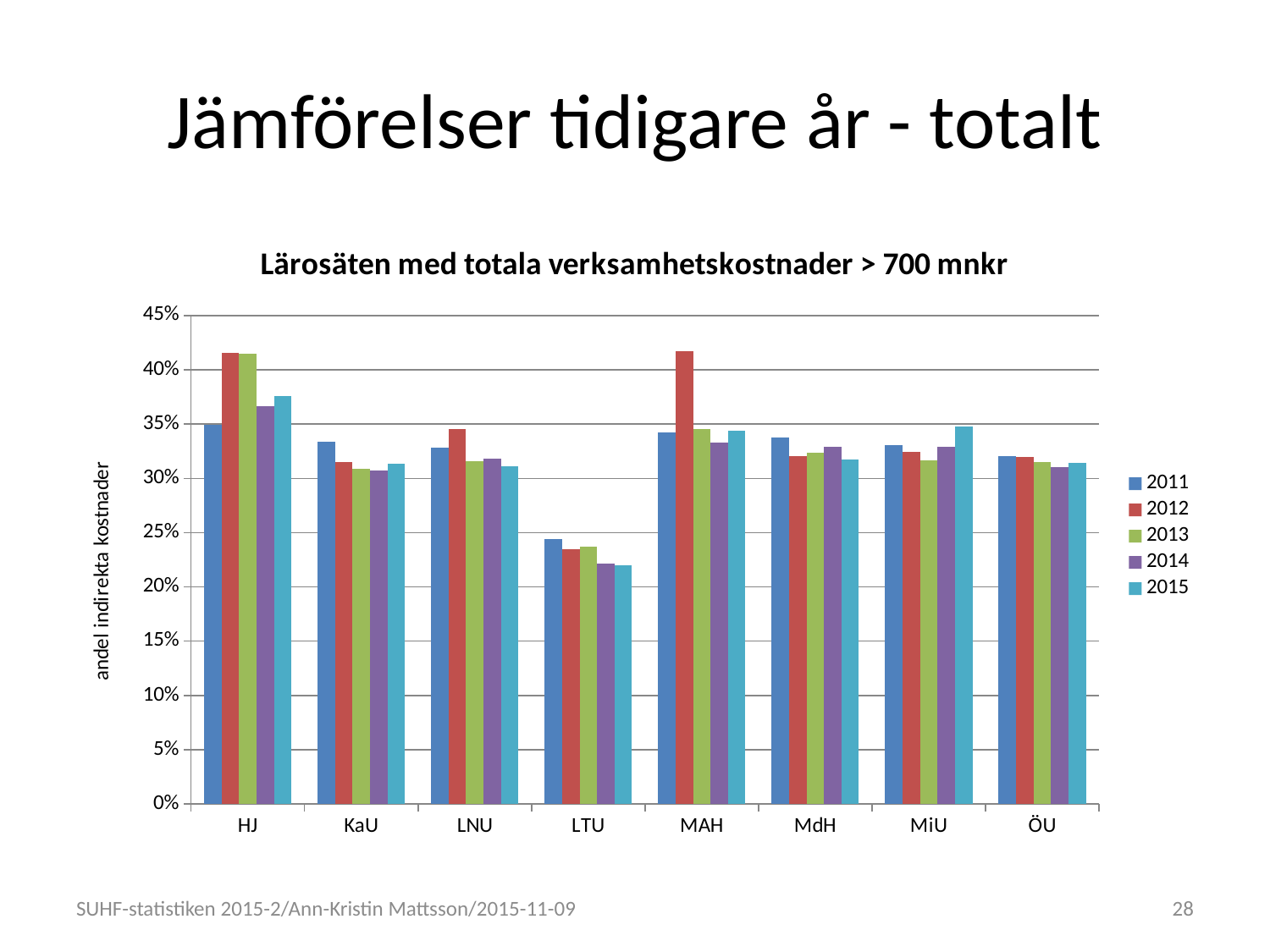
How many institutions (categories) are shown on the x axis? 8 Which is larger: the 2012 value for MAH or the 2012 value for MdH? MAH What kind of chart is shown on the slide? bar chart Is the value for HJ in 2012 greater or less than 40%? greater How many series does the legend list? 5 Which institution has the highest value for 2011? HJ Is the value for LTU in 2011 greater or less than 25%? less What is the title of the chart? Lärosäten med totala verksamhetskostnader > 700 mnkr Is the value for MiU in 2015 greater or less than 30%? greater Which institution has the lowest value for 2015? LTU What is the label on the y axis? andel indirekta kostnader